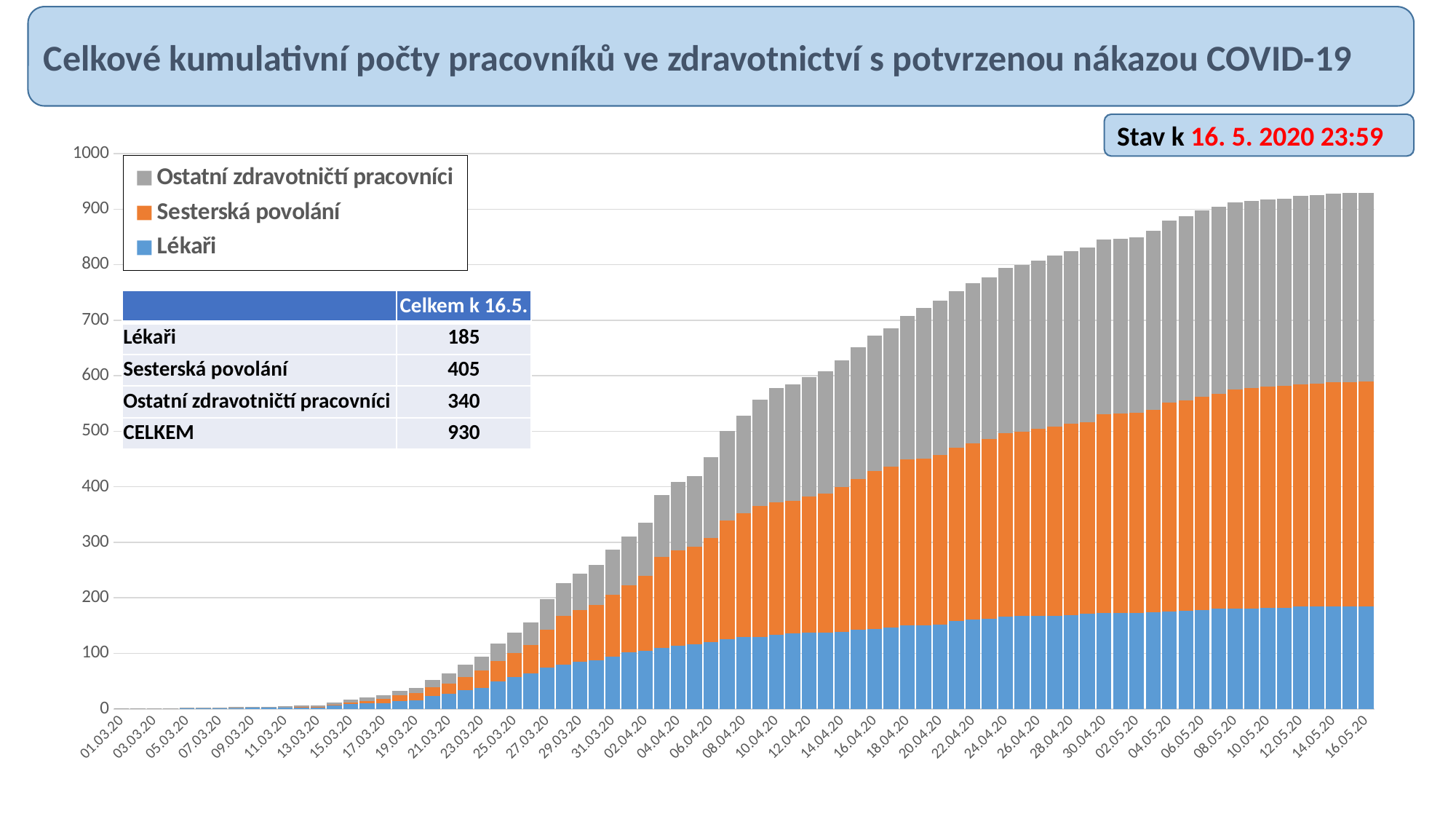
What is the value for Ostatní zdravotničtí pracovníci as of 16.5.? 340 Which series has the highest value as of 16.5.? Sesterská povolání Do the cumulative totals rise or fall along the x axis from 01.03.20 to 16.05.20? Rise What is the total of the stacked bar for 16.05.20 (CELKEM)? 930 Which series are listed in the chart legend? Ostatní zdravotničtí pracovníci, Sesterská povolání, Lékaři What colour represents the Lékaři series in the chart? Blue What is the difference between Sesterská povolání and Lékaři as of 16.5.? 220 How many series does the chart legend list? 3 Which series has the lowest value as of 16.5.? Lékaři What is the value for Sesterská povolání as of 16.5.? 405 What kind of chart is shown on the slide? Stacked bar chart What is the value for Lékaři as of 16.5. according to the table on the slide? 185